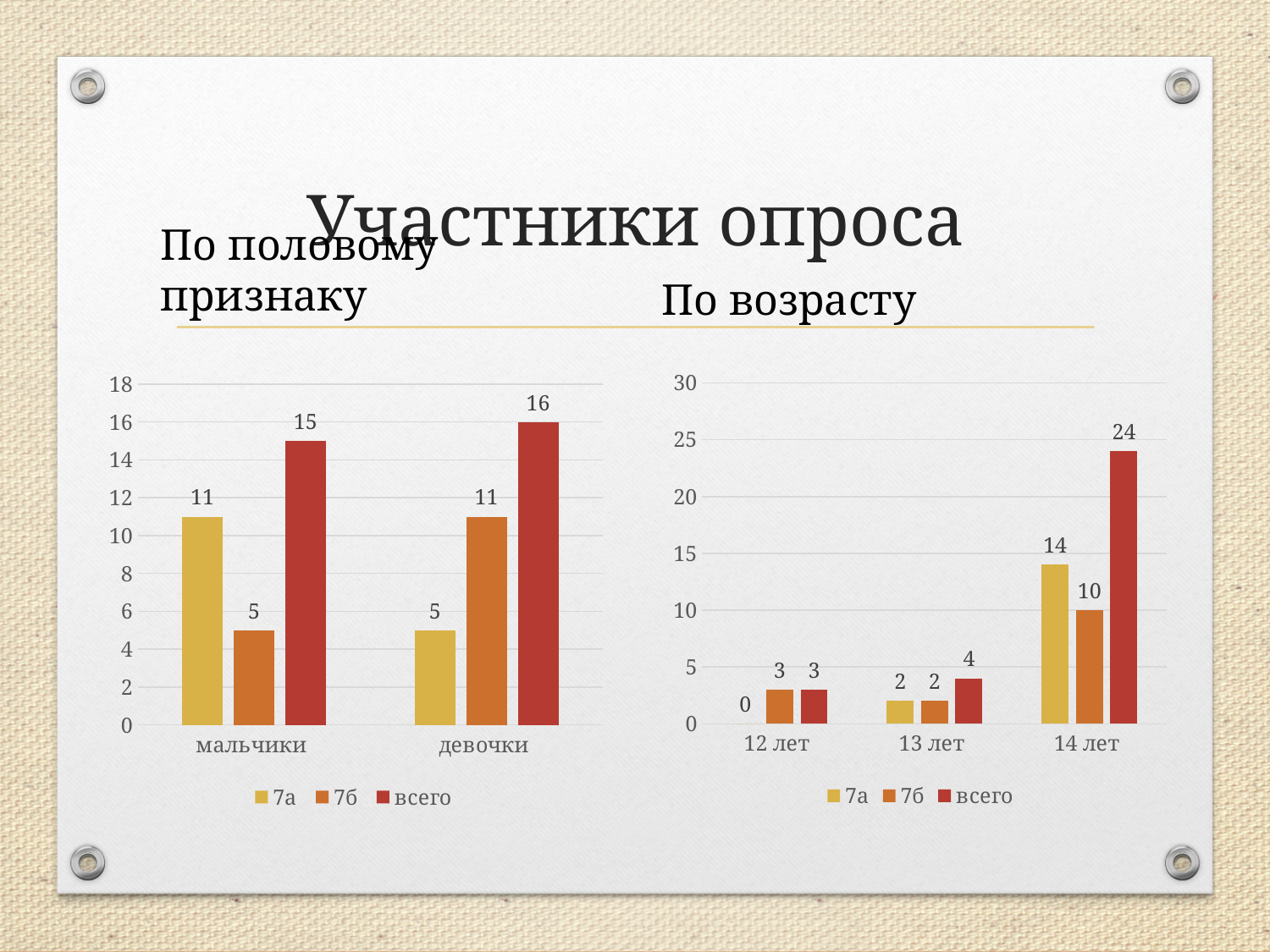
In the left chart (По половому признаку), how many series does the legend list? 3 In the left chart (По половому признаку), what is the value for 7а for мальчики? 11 In the right chart (По возрасту), what is the value for всего for 14 лет? 24 In the left chart (По половому признаку), what is the value for всего for девочки? 16 In the right chart (По возрасту), what is the difference between 7а and 7б for 14 лет? 4 In the right chart (По возрасту), how many age categories are shown on the x axis? 3 In the right chart (По возрасту), what is the value for 7а for 12 лет? 0 In the right chart (По возрасту), which age category has the lowest всего value? 12 лет What type of chart is the right chart (По возрасту)? bar chart In the left chart (По половому признаку), what is the difference between всего for девочки and всего for мальчики? 1 In the left chart (По половому признаку), which is larger: 7а for мальчики or 7а for девочки? мальчики In the right chart (По возрасту), which age category has the highest всего value? 14 лет